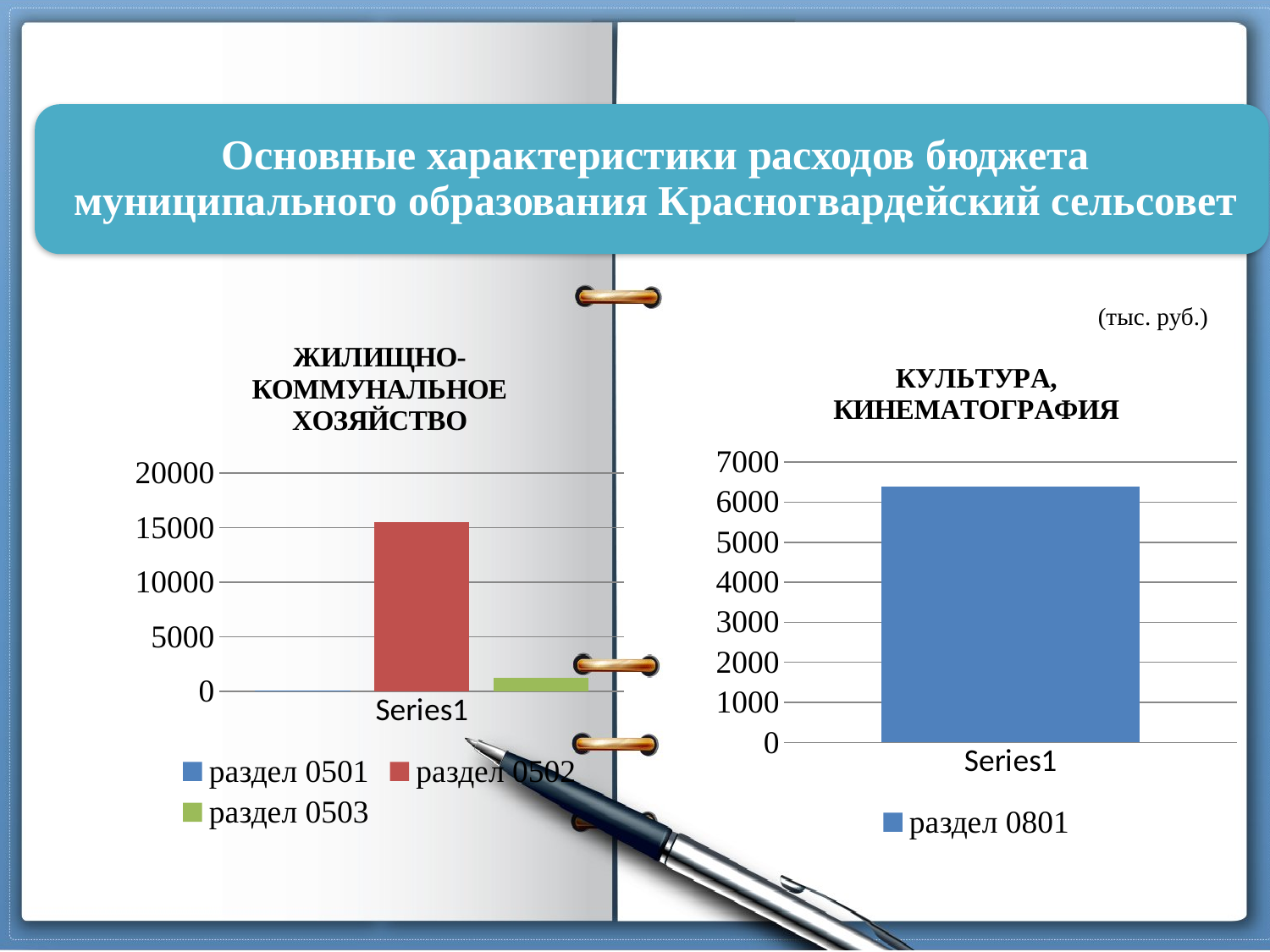
How many series does the legend of the chart titled ЖИЛИЩНО-КОММУНАЛЬНОЕ ХОЗЯЙСТВО list? 3 What colour is the bar for раздел 0502 in the chart titled ЖИЛИЩНО-КОММУНАЛЬНОЕ ХОЗЯЙСТВО? red What kind of chart is the chart titled ЖИЛИЩНО-КОММУНАЛЬНОЕ ХОЗЯЙСТВО? bar chart In the chart titled ЖИЛИЩНО-КОММУНАЛЬНОЕ ХОЗЯЙСТВО, which is larger: раздел 0502 or раздел 0503? раздел 0502 In the chart titled КУЛЬТУРА, КИНЕМАТОГРАФИЯ, is the value for раздел 0801 greater or less than 7000? less How many series does the legend of the chart titled КУЛЬТУРА, КИНЕМАТОГРАФИЯ list? 1 What is the name of the only series in the legend of the chart titled КУЛЬТУРА, КИНЕМАТОГРАФИЯ? раздел 0801 In the chart titled КУЛЬТУРА, КИНЕМАТОГРАФИЯ, is the value for раздел 0801 greater or less than 6000? greater In the chart titled ЖИЛИЩНО-КОММУНАЛЬНОЕ ХОЗЯЙСТВО, is the value for раздел 0503 greater or less than 5000? less In the chart titled ЖИЛИЩНО-КОММУНАЛЬНОЕ ХОЗЯЙСТВО, which series has the highest value? раздел 0502 In the chart titled ЖИЛИЩНО-КОММУНАЛЬНОЕ ХОЗЯЙСТВО, which series has the lowest value? раздел 0501